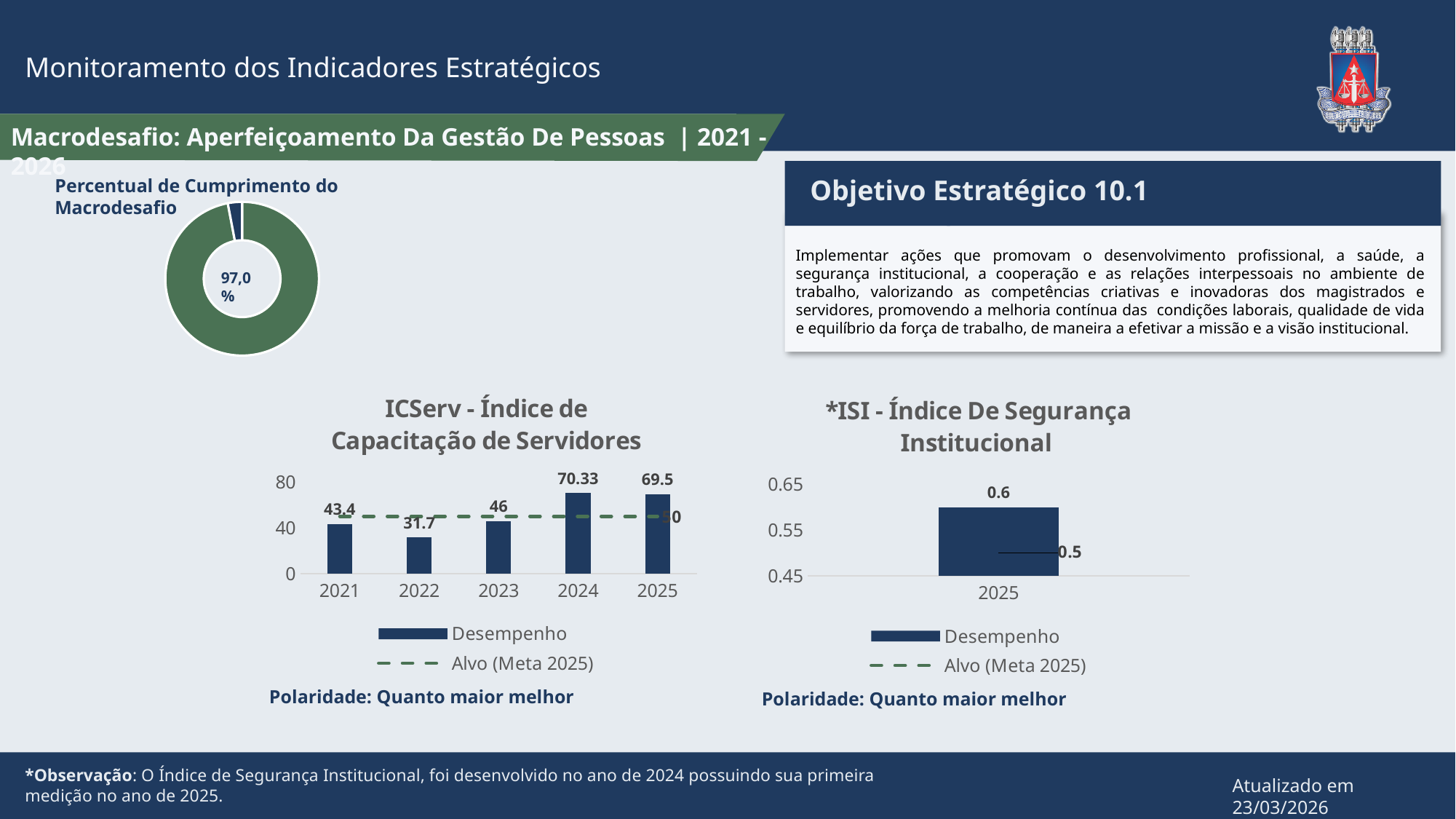
In the ICServ - Índice de Capacitação de Servidores chart, what is the Desempenho value for 2024? 70.33 In the *ISI - Índice De Segurança Institucional chart, what is the Desempenho value for 2025? 0.6 In the ICServ - Índice de Capacitação de Servidores chart, what is the Desempenho value for 2022? 31.7 In the *ISI - Índice De Segurança Institucional chart, what is the difference between the 2025 Desempenho value and the Alvo (Meta 2025)? 0.1 What percentage is shown in the Percentual de Cumprimento do Macrodesafio donut chart? 97,0% In the ICServ - Índice de Capacitação de Servidores chart, how many years are shown on the x axis? 5 In the ICServ - Índice de Capacitação de Servidores chart, is the Desempenho value for 2021 larger or smaller than the value for 2023? smaller In the ICServ - Índice de Capacitação de Servidores chart, what is the Alvo (Meta 2025) value? 50 In the ICServ - Índice de Capacitação de Servidores chart, what is the difference between the 2024 and 2025 Desempenho values? 0.83 How many entries does the legend of the *ISI - Índice De Segurança Institucional chart list? 2 In the ICServ - Índice de Capacitação de Servidores chart, which year has the lowest Desempenho value? 2022 In the ICServ - Índice de Capacitação de Servidores chart, which year has the highest Desempenho value? 2024